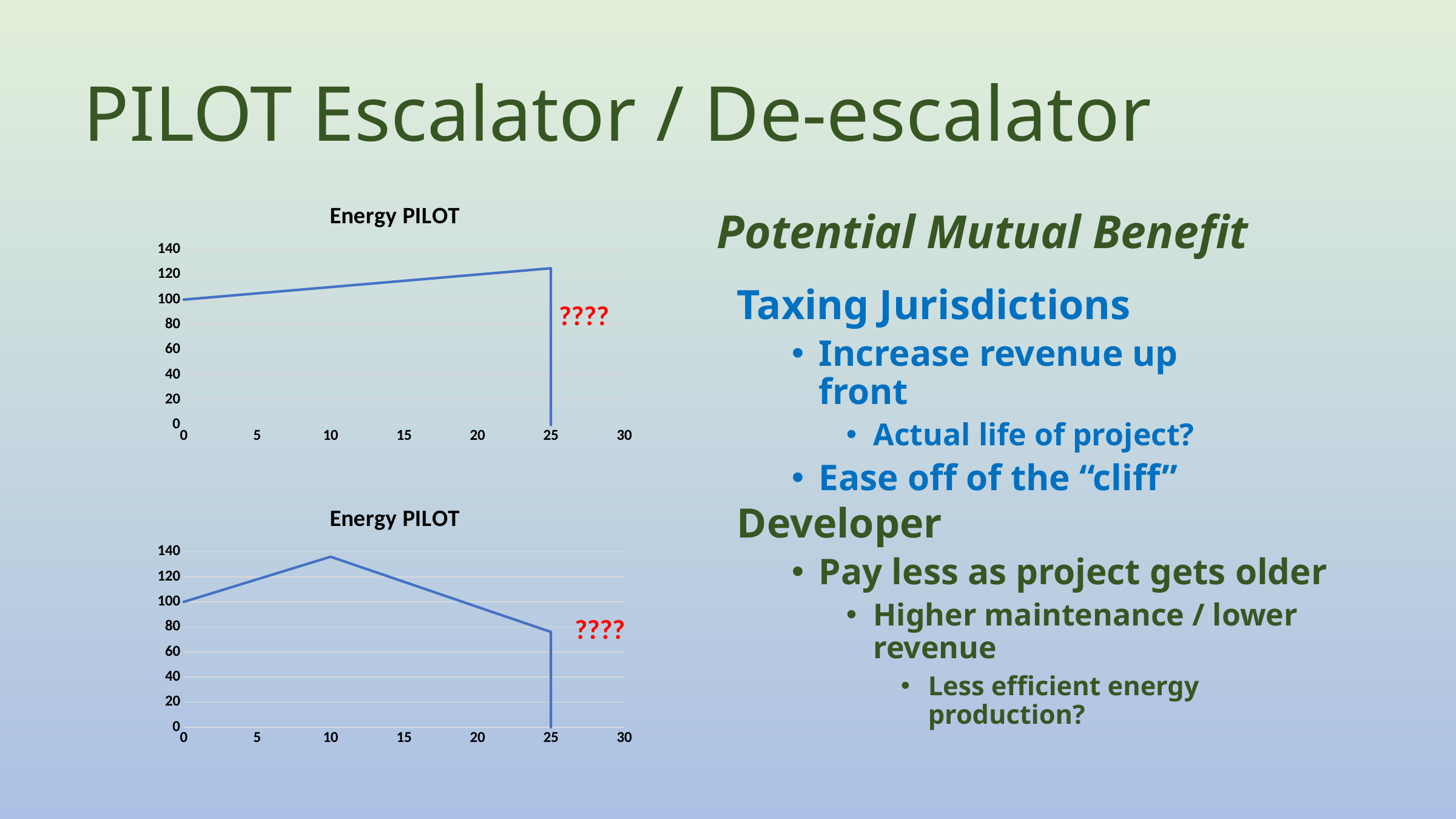
In the bottom chart, what is the value of the line at x = 0? 100 What is the title of the top chart? Energy PILOT In the bottom chart, is the value at x = 10 greater or less than 120? greater What is the highest value shown on the y axis of the top chart? 140 What type of chart is the top chart on the slide? line chart In the top chart, does the line rise or fall between x = 0 and x = 25? rise In the top chart, is the value at x = 25 (just before the drop) greater or less than 120? greater What type of chart is the bottom chart on the slide? line chart In the top chart, what is the value of the line at x = 0? 100 In the bottom chart, does the line rise or fall between x = 10 and x = 25? fall In the bottom chart, is the value at x = 25 (just before the drop) greater or less than 80? less In the bottom chart, at which x-axis value does the line reach its highest point? 10